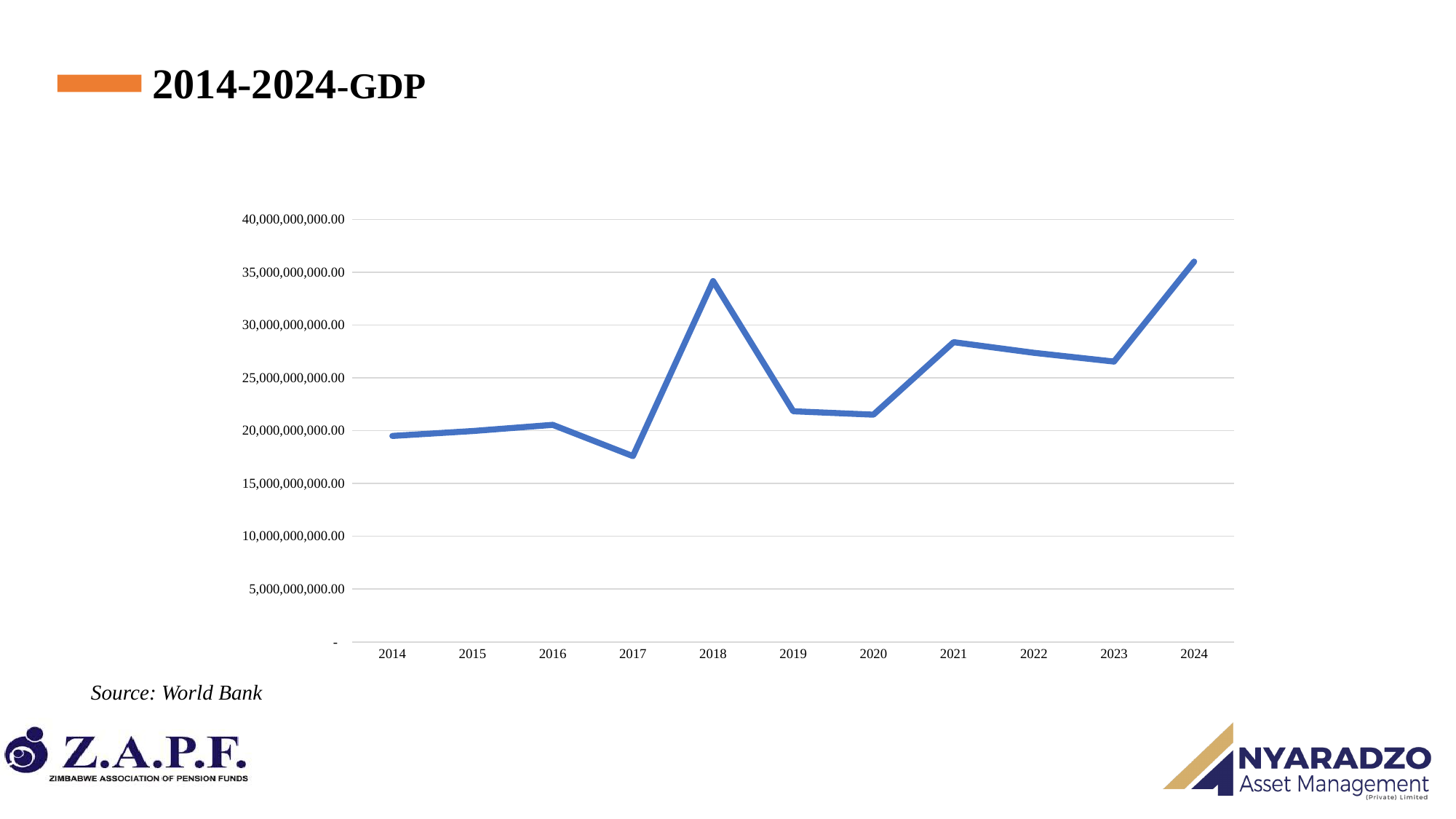
Is the GDP value for 2021 greater or less than 25,000,000,000.00? greater Is the GDP value for 2024 greater or less than 30,000,000,000.00? greater Which year has the lowest GDP value? 2017 Which year has the highest GDP value? 2024 What is the title of the slide? 2014-2024-GDP Is the GDP value for 2018 greater or less than 30,000,000,000.00? greater Does the GDP value rise or fall from 2021 to 2023? Fall What kind of chart is shown on the slide? Line chart Which year has the larger GDP value, 2018 or 2019? 2018 Which year has the larger GDP value, 2021 or 2023? 2021 How many years are plotted along the x axis? 11